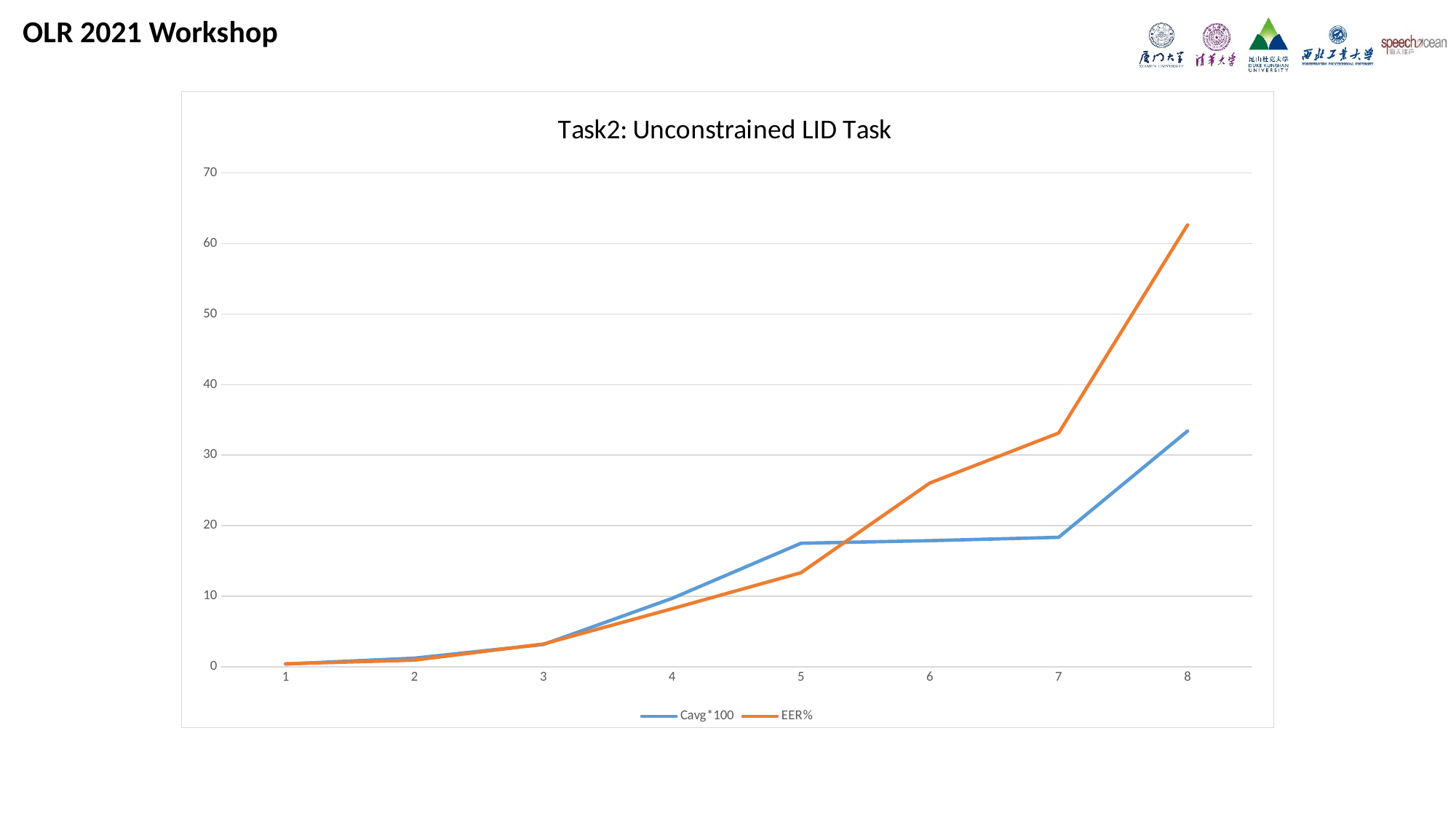
What is the title of the chart? Task2: Unconstrained LID Task How many series does the legend list? 2 Is the Cavg*100 value at x = 8 greater or less than 30? greater How many points are plotted along the x axis for each series? 8 Is the EER% value at x = 8 greater or less than 60? greater At x = 5, which series has the larger value, Cavg*100 or EER%? Cavg*100 At x = 8, which series has the larger value, Cavg*100 or EER%? EER% What kind of chart is shown on the slide? line chart Is the EER% value at x = 6 greater or less than 20? greater At which x value does the EER% series reach its highest point? 8 Does the EER% series rise or fall from x = 1 to x = 8? rise